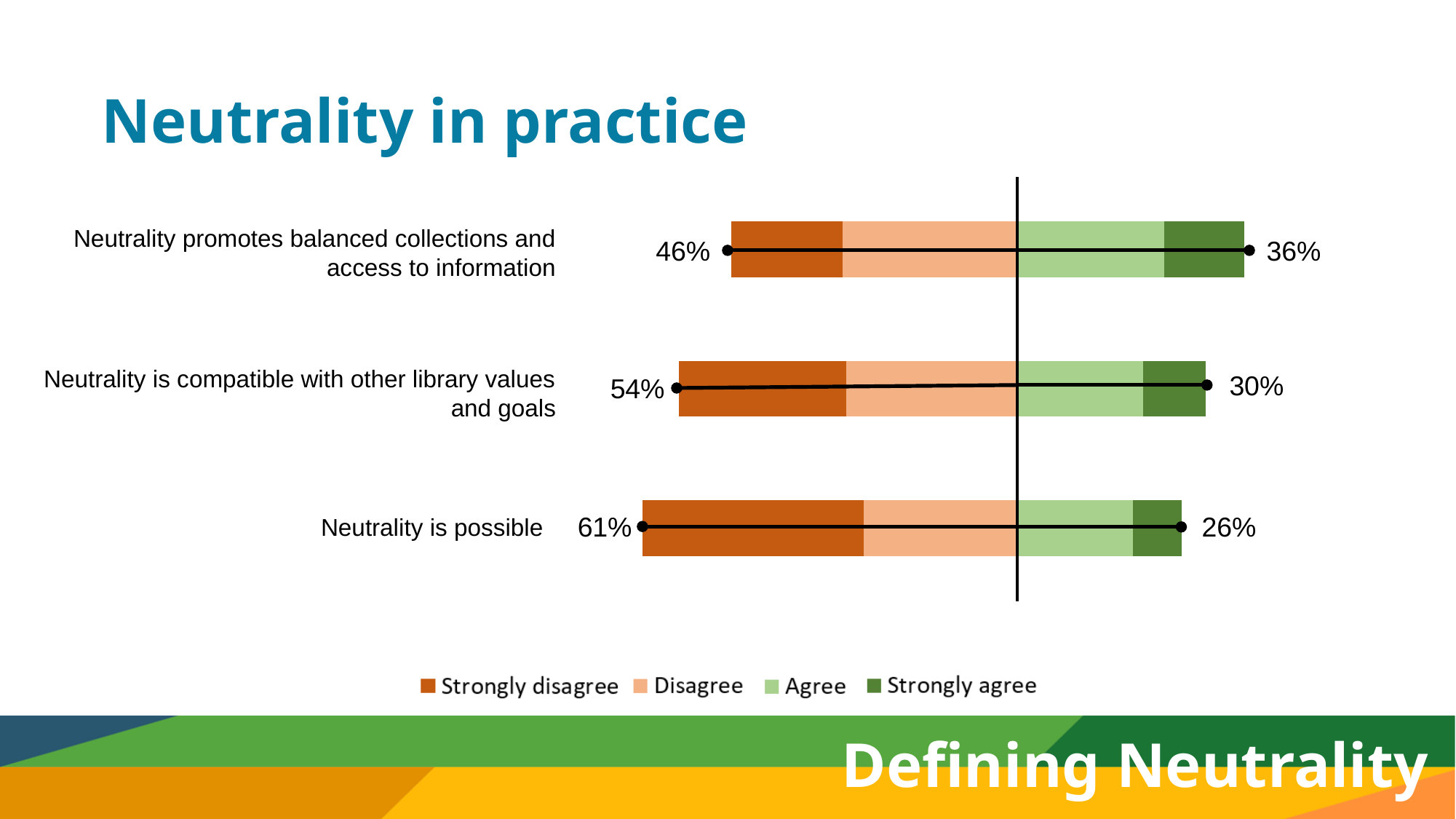
What is the difference between the disagreement and agreement percentages for "Neutrality is possible"? 35 percentage points What percentage disagreed with the statement "Neutrality is compatible with other library values and goals"? 54% Which statement has the highest disagreement percentage? Neutrality is possible What is the difference between the disagreement percentages for "Neutrality is possible" and "Neutrality promotes balanced collections and access to information"? 15 percentage points What percentage agreed (agree plus strongly agree) with the statement "Neutrality promotes balanced collections and access to information"? 36% How many statements are shown in the chart? 3 Which is larger: the agreement percentage for "Neutrality is compatible with other library values and goals" or for "Neutrality is possible"? Neutrality is compatible with other library values and goals Which statement has the lowest agreement percentage? Neutrality is possible How many response categories does the legend list? 4 What type of chart is shown on the slide? Bar chart What percentage disagreed (strongly disagree plus disagree) with the statement "Neutrality is possible"? 61% What percentage agreed with the statement "Neutrality is possible"? 26%